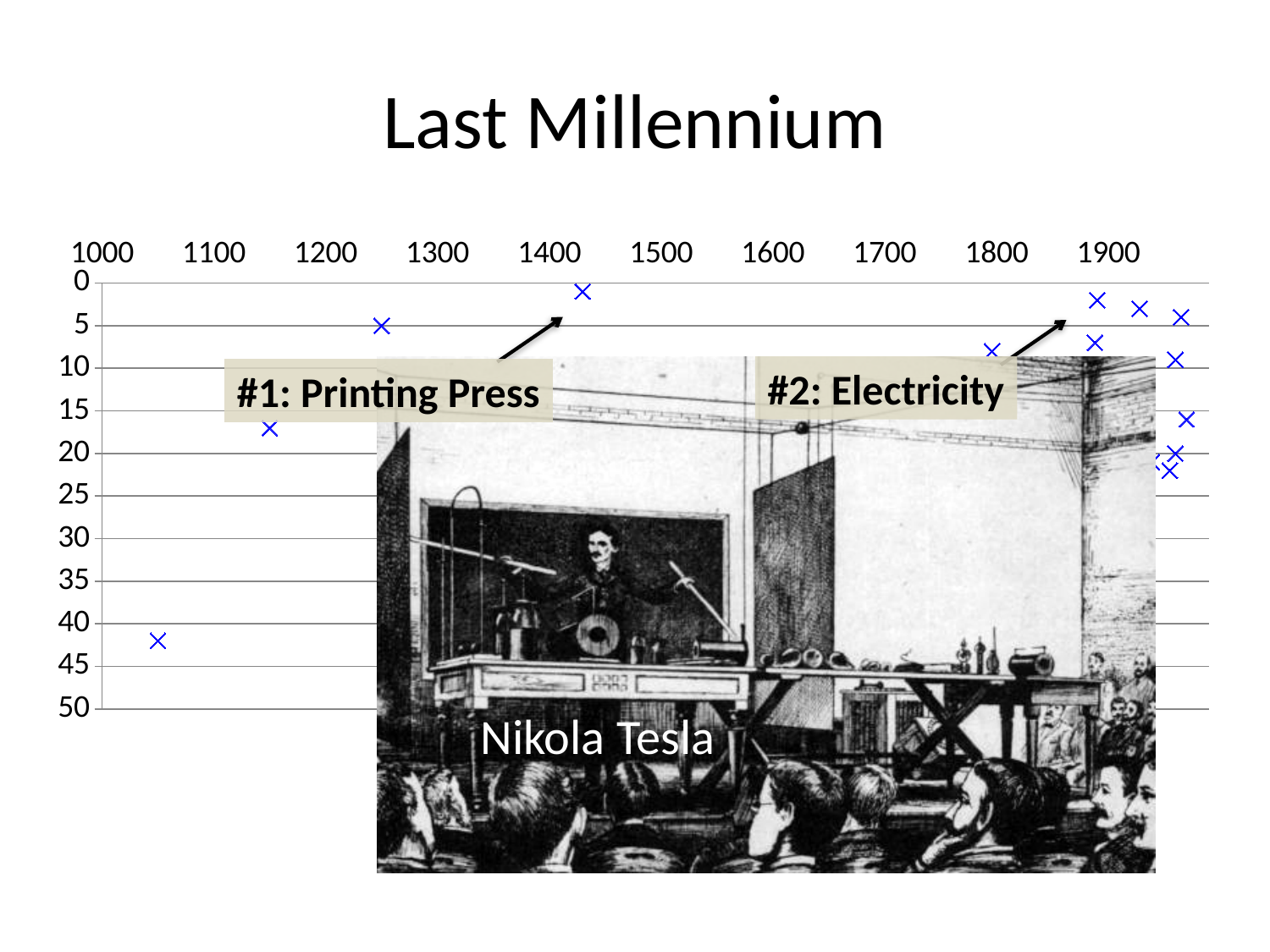
Is the value for the point near the year 1800 greater or less than 5? greater Which has the larger plotted value, the point near 1050 or the point near 1250? the point near 1050 What is the highest value shown on the vertical axis? 50 What is the title of the chart on the slide? Last Millennium Is the value for the point near the year 1050 greater or less than 30? greater Which two annotations label points on the chart? #1: Printing Press and #2: Electricity Is the value for the point labelled '#1: Printing Press' (near 1430) greater or less than 5? less What kind of chart is shown on the slide? scatter chart